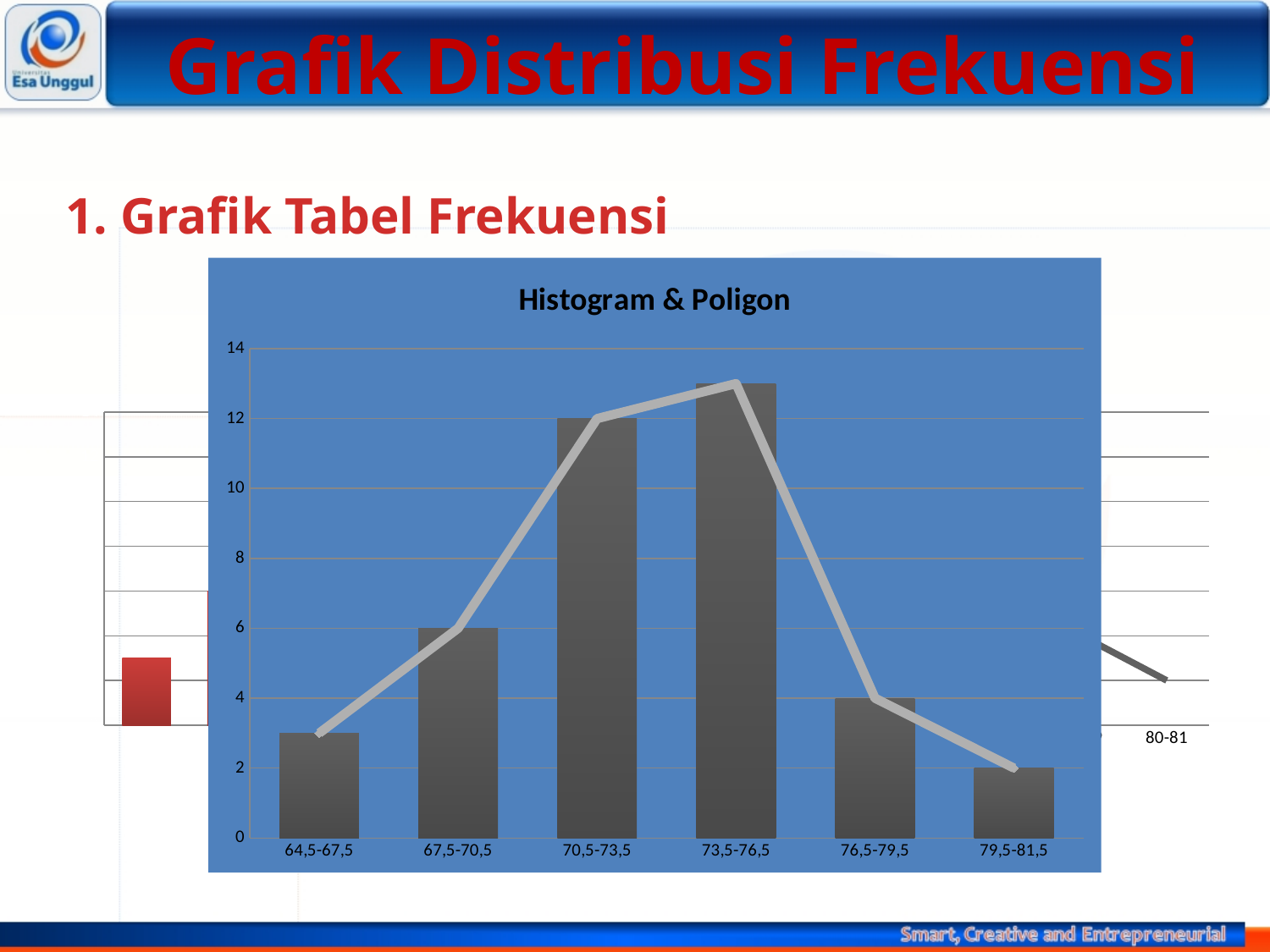
Is the frequency for the class interval 73,5-76,5 greater or less than 12? greater What is the frequency for the class interval 79,5-81,5? 2 Which class interval has the lowest frequency in the Histogram & Poligon chart? 79,5-81,5 Is the frequency for the class interval 64,5-67,5 greater or less than 4? less What is the title of the chart on the slide? Histogram & Poligon What is the difference between the frequencies of 70,5-73,5 and 67,5-70,5? 6 How many class intervals are shown on the x axis of the Histogram & Poligon chart? 6 Which class interval has the highest frequency in the Histogram & Poligon chart? 73,5-76,5 What is the frequency for the class interval 67,5-70,5? 6 What is the frequency for the class interval 70,5-73,5? 12 Which has a higher frequency, 76,5-79,5 or 67,5-70,5? 67,5-70,5 What is the frequency for the class interval 76,5-79,5? 4